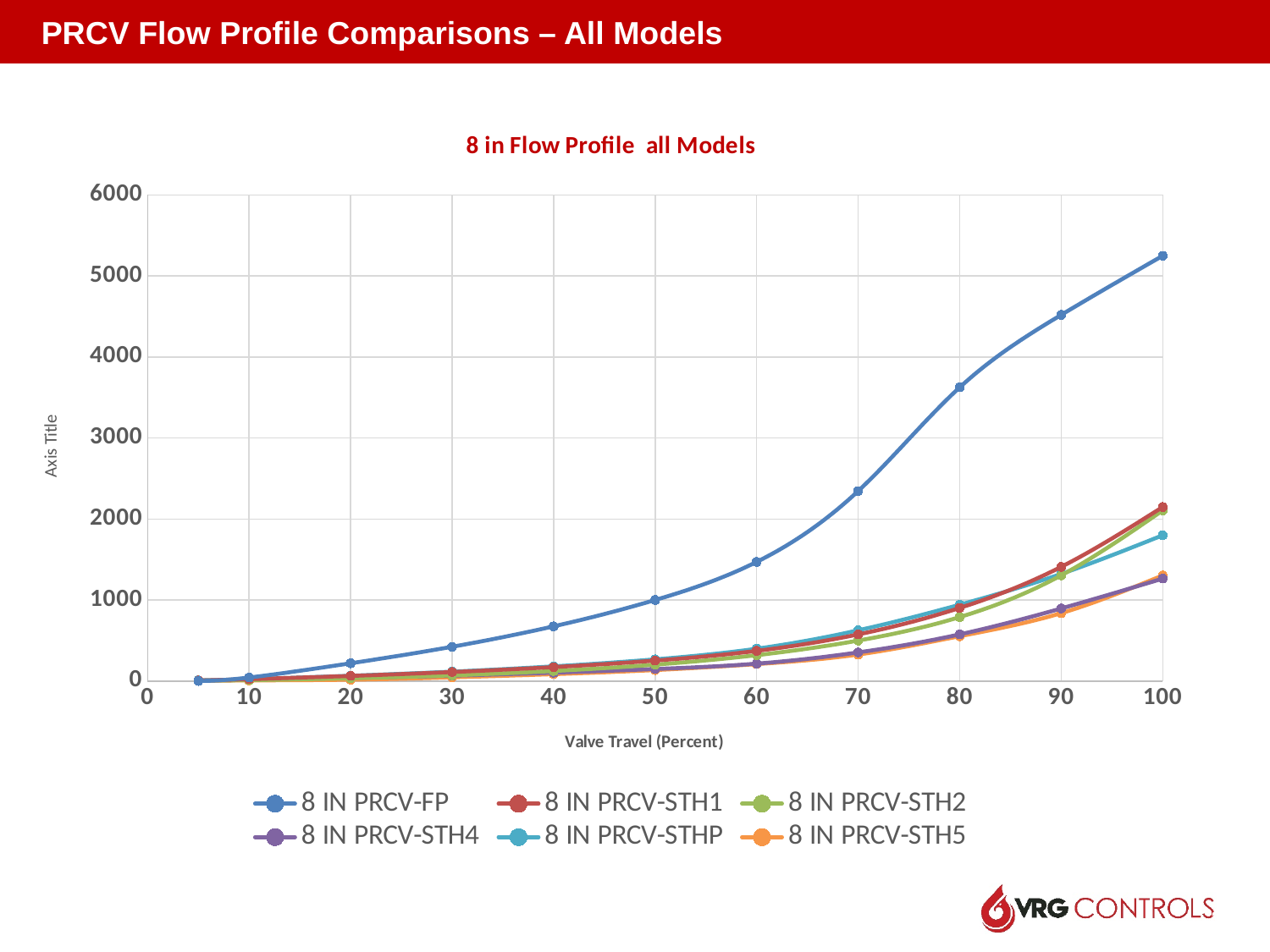
Is the value for 8 IN PRCV-STHP at 100 percent valve travel greater or less than 2000? less At 100 percent valve travel, which is larger: 8 IN PRCV-FP or 8 IN PRCV-STHP? 8 IN PRCV-FP At 100 percent valve travel, which is larger: 8 IN PRCV-STHP or 8 IN PRCV-STH4? 8 IN PRCV-STHP Is the value for 8 IN PRCV-STH4 at 100 percent valve travel greater or less than 1000? greater What kind of chart is shown on the slide? Line chart Do the values for 8 IN PRCV-FP rise or fall as valve travel increases from 0 to 100 percent? Rise Is the value for 8 IN PRCV-FP at 100 percent valve travel greater or less than 5000? greater How many series does the legend list? 6 Which series has the highest value at 100 percent valve travel? 8 IN PRCV-FP What is the title of the chart? 8 in Flow Profile all Models What is the label on the x axis of the chart? Valve Travel (Percent)